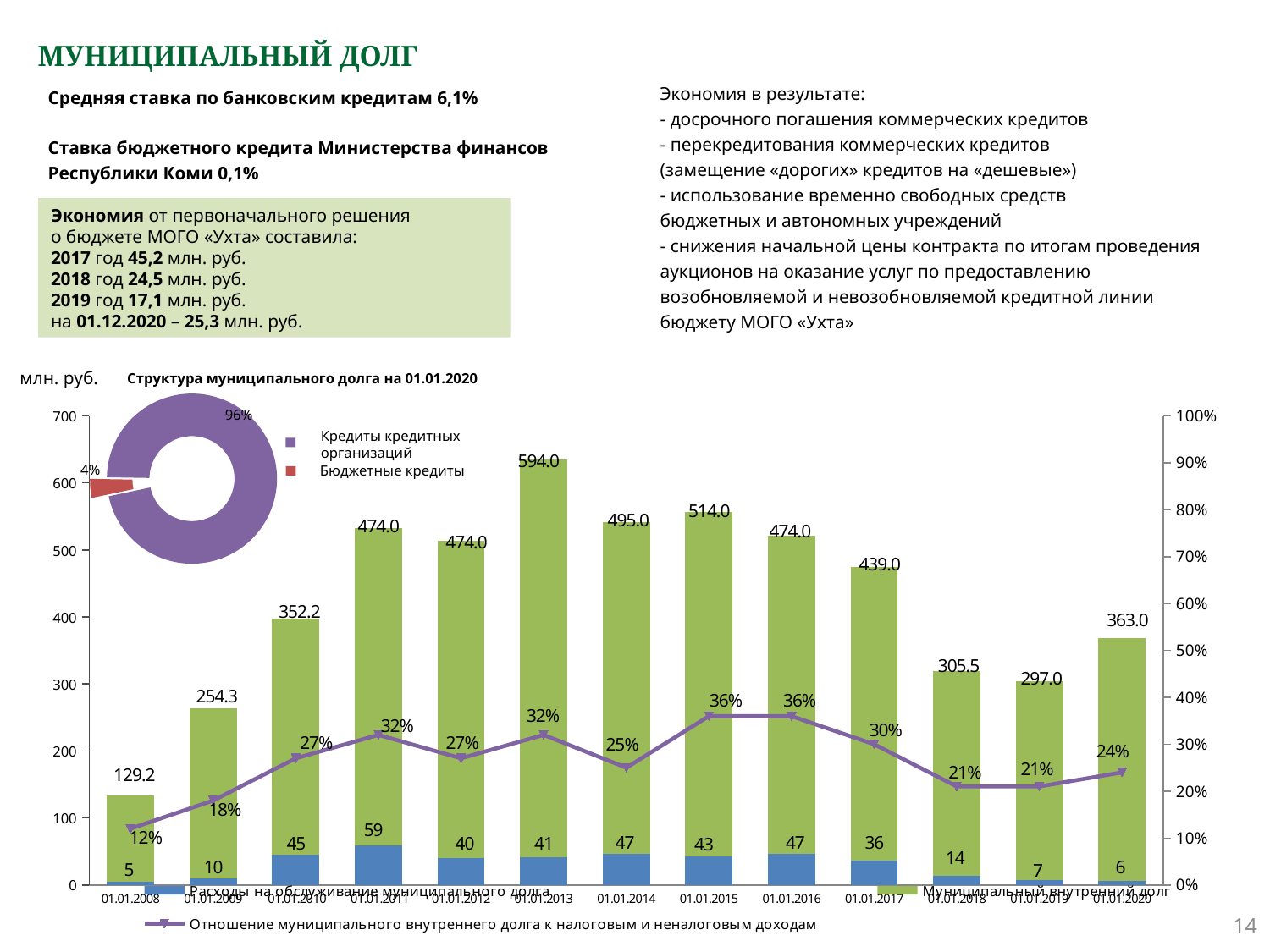
On the bar chart, which date has the highest value of Муниципальный внутренний долг? 01.01.2013 In the donut chart Структура муниципального долга на 01.01.2020, what share is Бюджетные кредиты? 4% On the bar chart, how many dates are shown on the x axis? 13 On the bar chart, how many series does the legend list? 3 On the bar chart, what is the value of Муниципальный внутренний долг for 01.01.2013? 594.0 On the bar chart, what is the value of Отношение муниципального внутреннего долга к налоговым и неналоговым доходам for 01.01.2015? 36% On the bar chart, what is the difference between Муниципальный внутренний долг for 01.01.2013 and 01.01.2014? 99.0 On the bar chart, what is the value of Расходы на обслуживание муниципального долга for 01.01.2011? 59 On the bar chart, which is larger: Муниципальный внутренний долг for 01.01.2019 or for 01.01.2020? 01.01.2020 On the bar chart, which date has the lowest value of Муниципальный внутренний долг? 01.01.2008 On the bar chart, what is the value of Муниципальный внутренний долг for 01.01.2020? 363.0 In the donut chart Структура муниципального долга на 01.01.2020, what share is Кредиты кредитных организаций? 96%